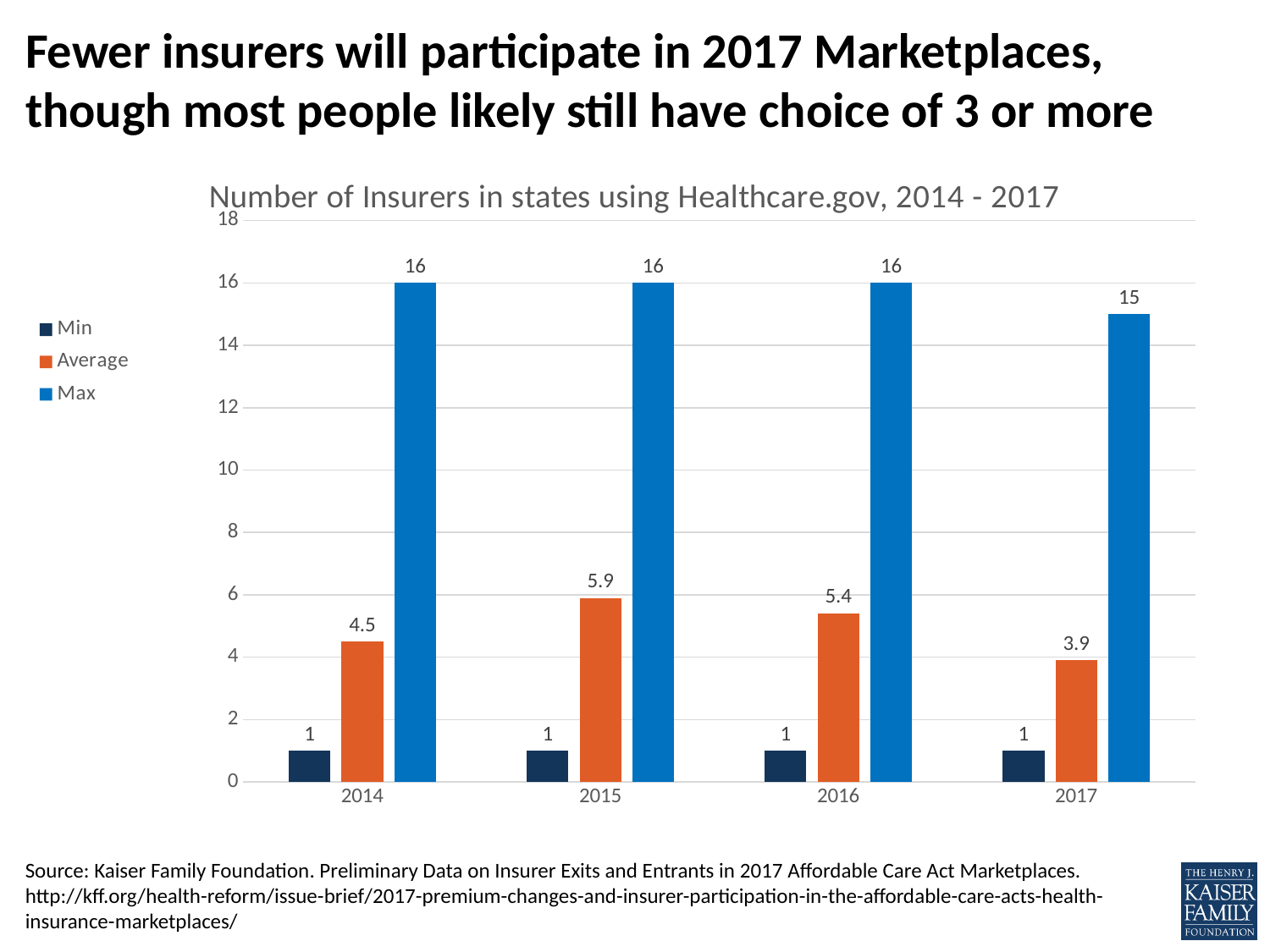
What is the Min number of insurers in 2014? 1 What is the difference between the Max number of insurers in 2016 and in 2017? 1 How many series does the legend list? 3 Which is larger, the Average number of insurers in 2014 or in 2016? 2016 What is the Max number of insurers in 2017? 15 Which year has the highest Average number of insurers? 2015 What is the difference between the Average number of insurers in 2015 and in 2017? 2 What is the Average number of insurers in 2015? 5.9 How many years are shown on the x axis? 4 What is the title of the chart? Number of Insurers in states using Healthcare.gov, 2014 - 2017 Which year has the lowest Average number of insurers? 2017 What kind of chart is shown on the slide? Bar chart